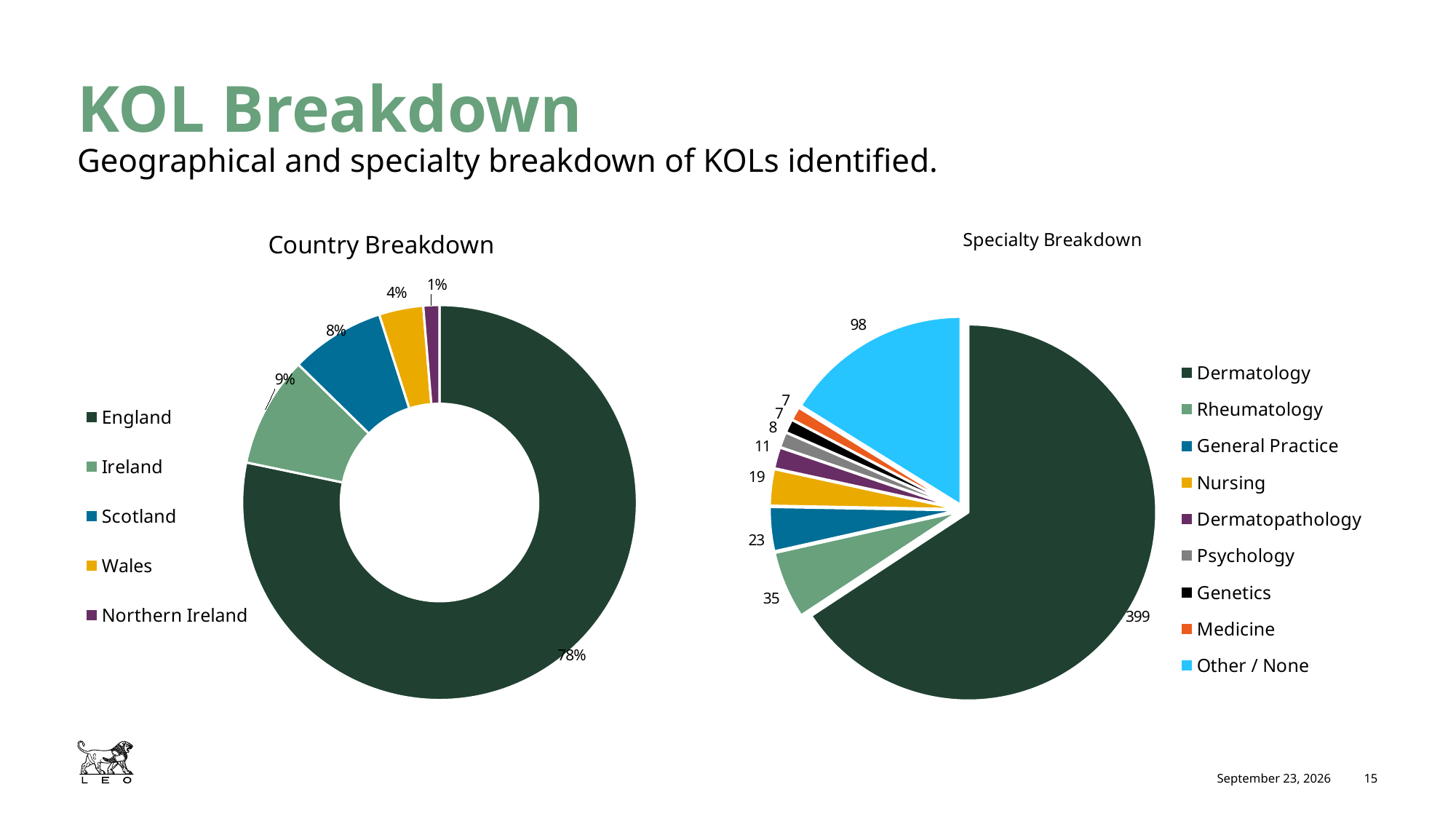
In the Country Breakdown chart, what percentage of KOLs are from England? 78% In the Specialty Breakdown chart, how many KOLs are in Dermatology? 399 In the Country Breakdown chart, what percentage of KOLs are from Scotland? 8% In the Specialty Breakdown chart, what is the difference between Rheumatology and Nursing? 16 In the Specialty Breakdown chart, how many specialty categories are listed in the legend? 9 In the Country Breakdown chart, how many countries are shown in the legend? 5 In the Specialty Breakdown chart, which is larger, Rheumatology or General Practice? Rheumatology In the Specialty Breakdown chart, how many KOLs are in the Other / None category? 98 In the Specialty Breakdown chart, which specialty has the largest number of KOLs? Dermatology In the Country Breakdown chart, which country has the smallest share? Northern Ireland What type of chart is the Country Breakdown chart? Doughnut chart In the Country Breakdown chart, what is the difference in percentage points between Ireland and Wales? 5